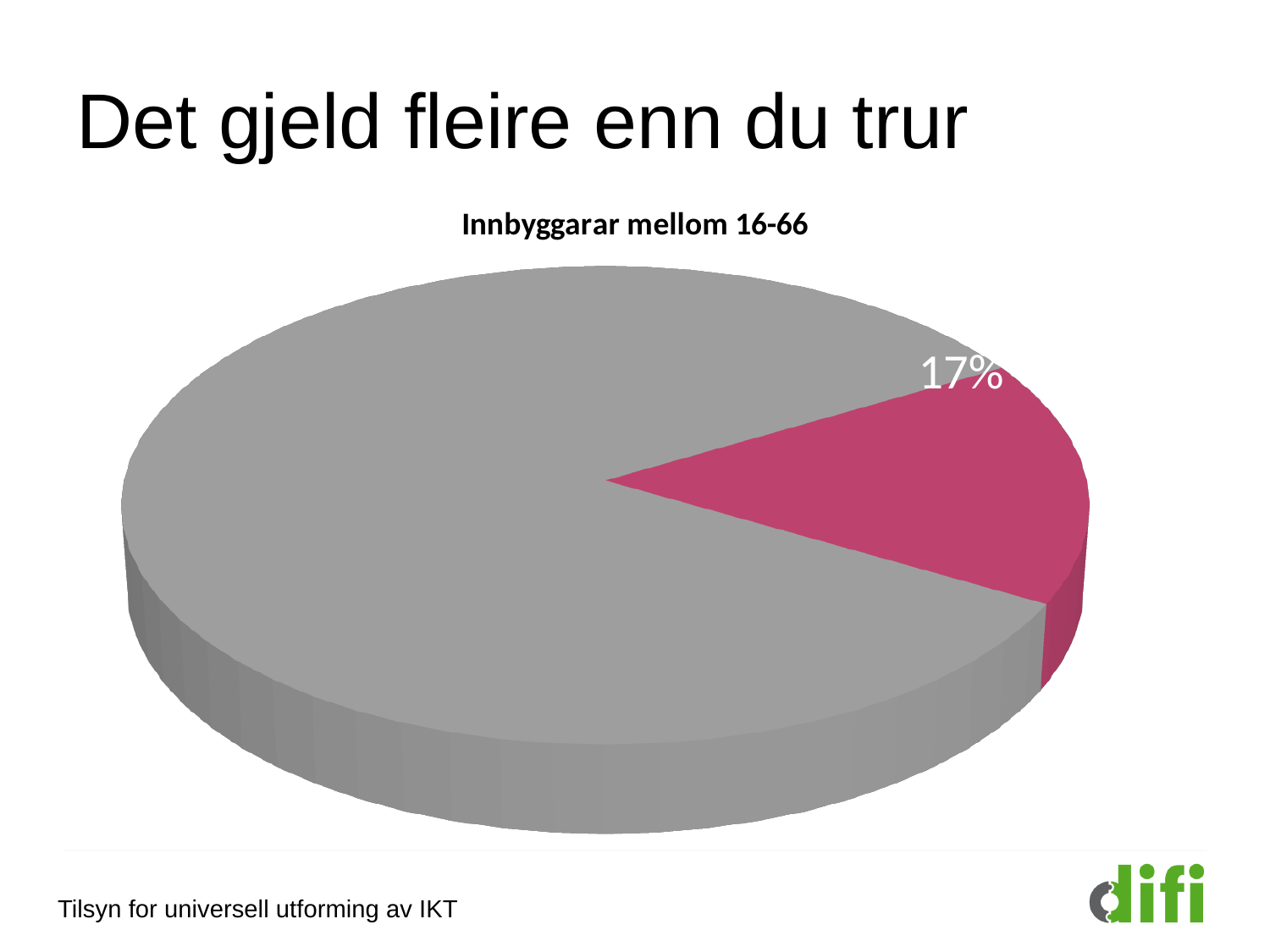
Which slice is the largest in the pie chart? The grey slice What kind of chart is shown on the slide? Pie chart What percentage is printed on the pink slice of the pie chart? 17% What colour is the slice that carries the 17% label? Pink What share of the pie does the pink slice represent? 17% Is the pink slice's share of the pie greater or less than 25%? less Which slice of the pie is larger, the grey slice or the pink slice? The grey slice Which slice is the smallest in the pie chart? The pink slice Is the grey slice's share of the pie greater or less than 50%? greater What is the title of the chart? Innbyggarar mellom 16-66 How many slices does the pie chart have? 2